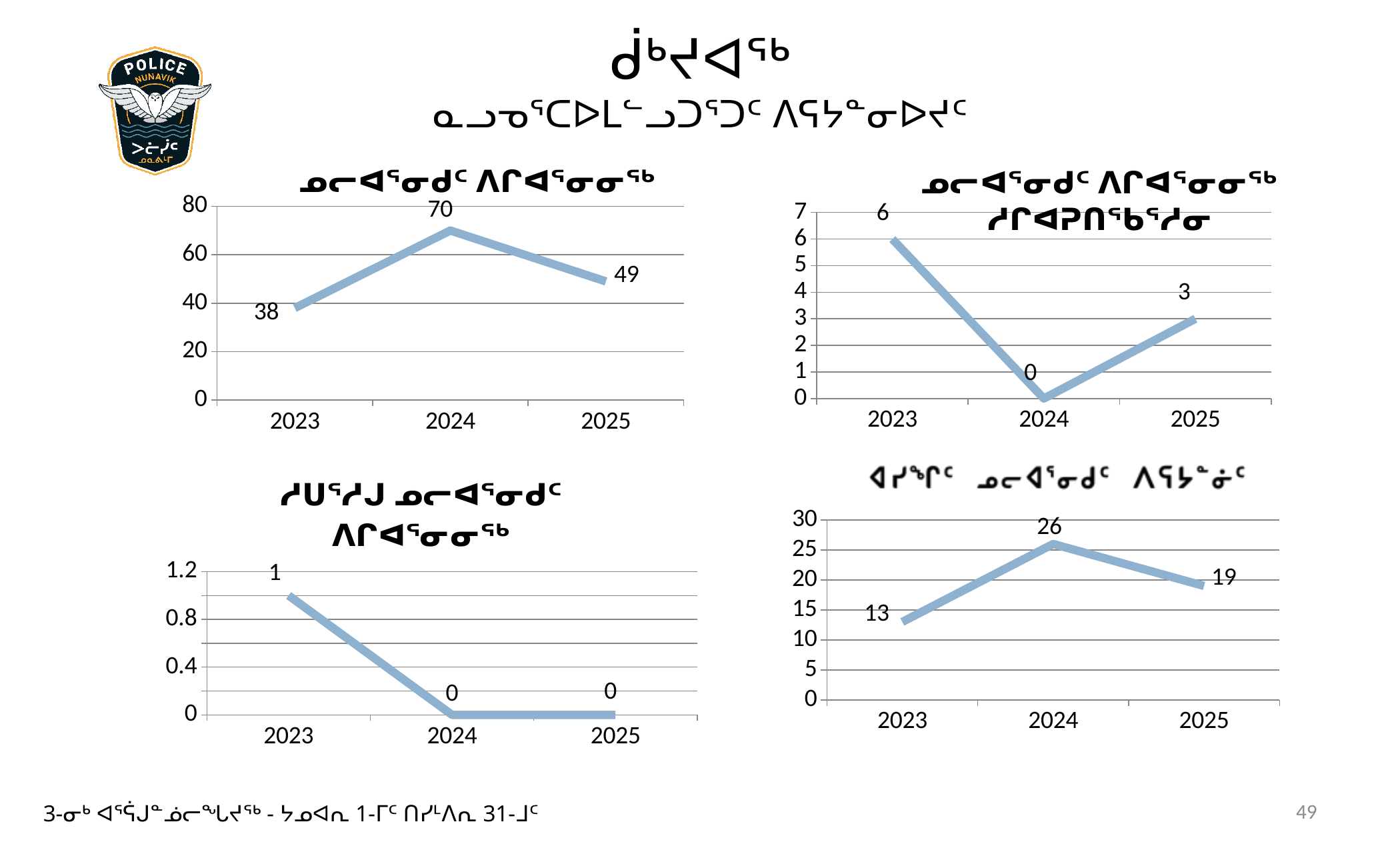
In the top-left chart, what is the value for 2024? 70 In the bottom-right chart, what is the difference between the 2024 and 2023 values? 13 In the top-left chart, what is the difference between the 2024 and 2025 values? 21 In the bottom-right chart, which is larger, the value for 2023 or the value for 2025? 2025 What kind of chart is the top-left chart? line chart In the top-right chart, which year has the highest value? 2023 In the top-right chart, what is the value for 2023? 6 In the top-left chart, which year has the lowest value? 2023 In the bottom-right chart, what is the value for 2024? 26 In the bottom-left chart, what is the value for 2023? 1 In the bottom-left chart, how many years are plotted on the x axis? 3 In the top-right chart, what is the value for 2024? 0